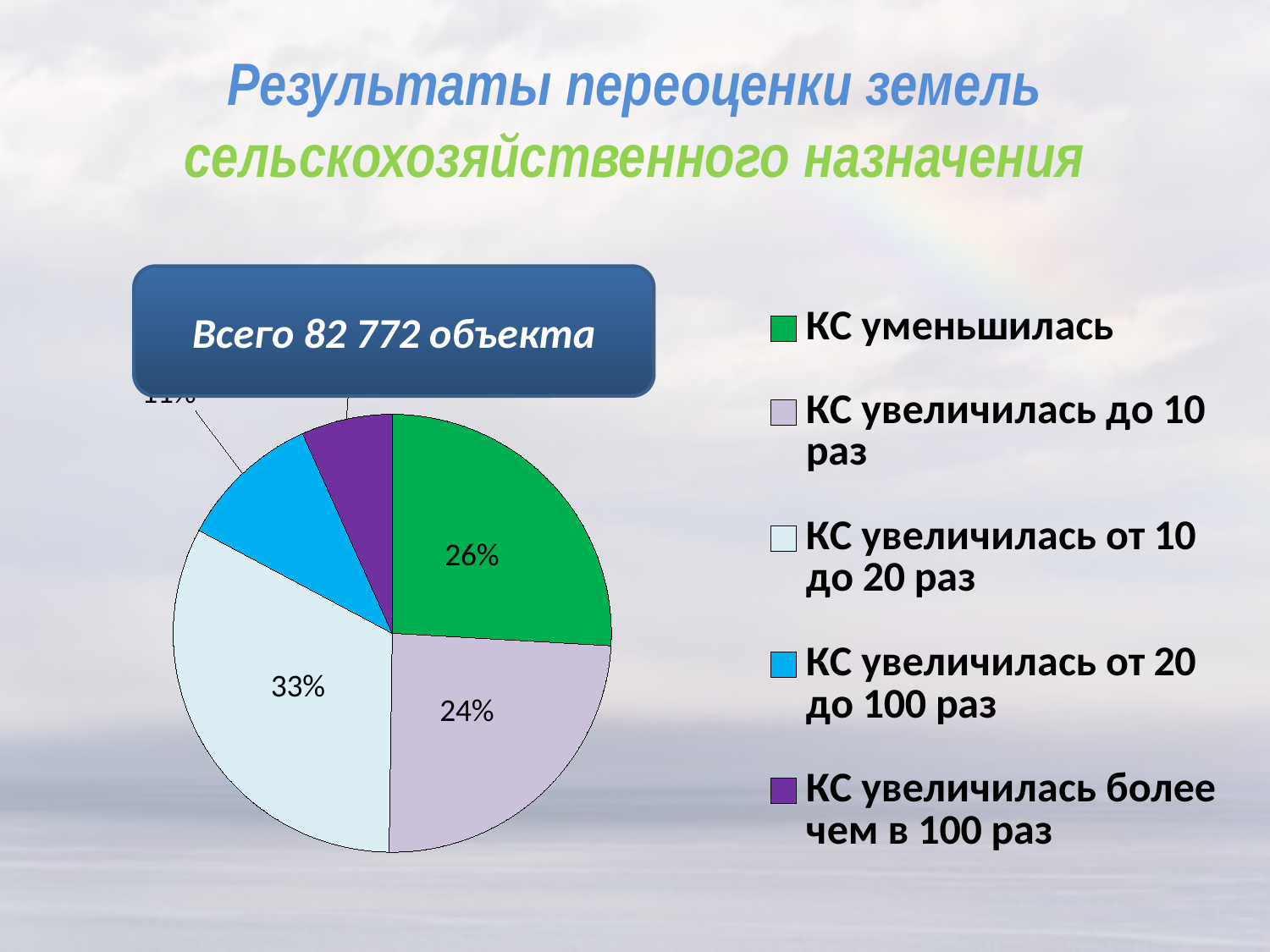
What share of the pie does the slice "КС увеличилась до 10 раз" have? 24% What is the difference in percentage points between the "КС увеличилась от 10 до 20 раз" slice and the "КС увеличилась до 10 раз" slice? 9 percentage points What colour is the slice for "КС уменьшилась"? green What total number of objects is stated in the box above the chart? 82 772 объекта How many slices does the pie chart have? 5 Which slice is larger: "КС уменьшилась" or "КС увеличилась до 10 раз"? КС уменьшилась Which category has the smallest slice of the pie? КС увеличилась более чем в 100 раз How many entries does the legend list? 5 Which category has the largest slice of the pie? КС увеличилась от 10 до 20 раз What type of chart is shown on the slide? pie chart What share of the pie does the slice "КС увеличилась от 10 до 20 раз" have? 33% What share of the pie does the slice "КС уменьшилась" have? 26%